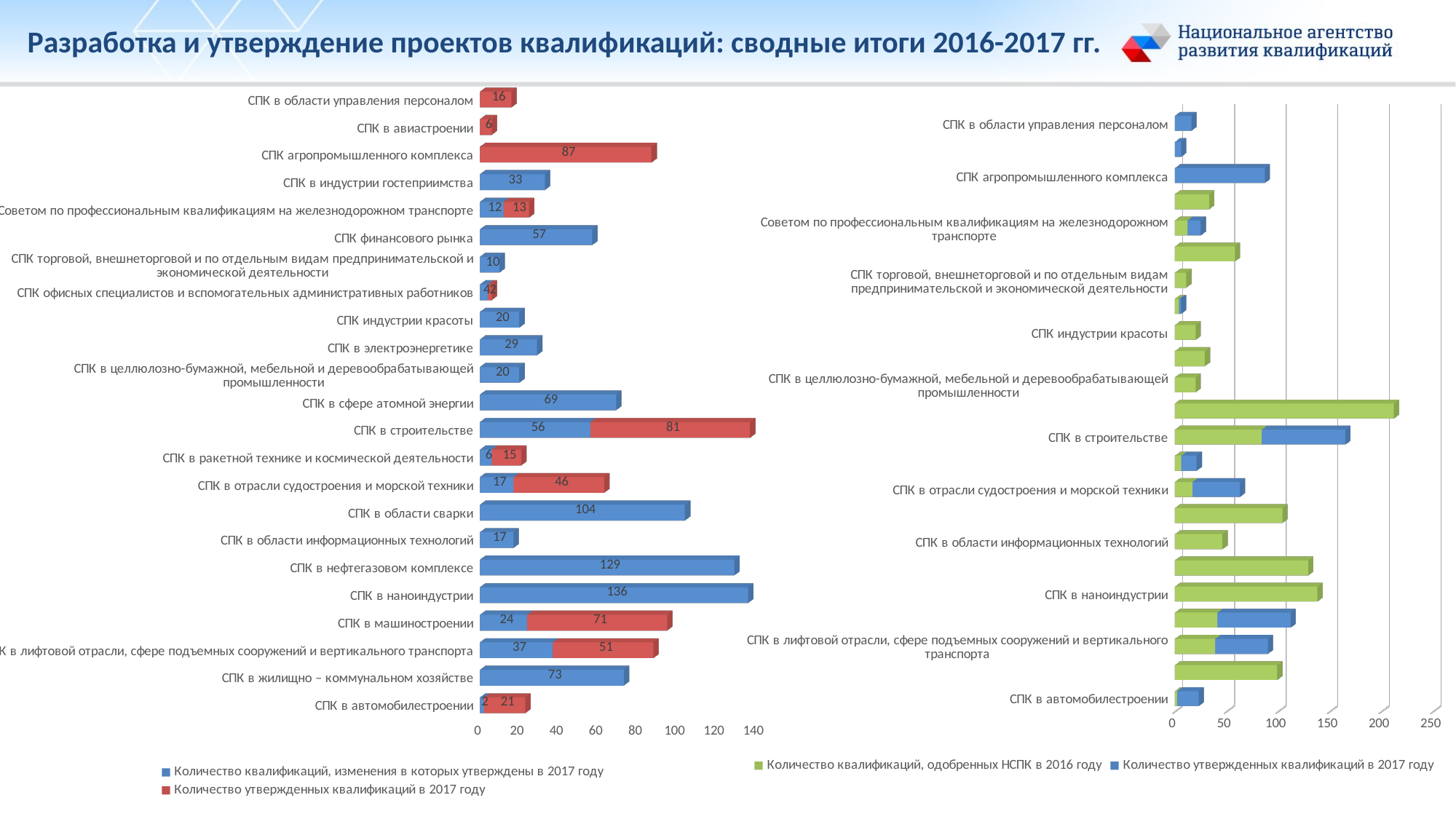
What kind of chart is the chart on the left of the slide? Bar chart On the left chart, what is the total of the stacked bar for СПК в машиностроении? 95 How many series does the legend of the left chart list? 2 On the right chart, is the green-series value (Количество квалификаций, одобренных НСПК в 2016 году) for СПК в строительстве greater or less than 200? less On the right chart, is the blue-series value (Количество утвержденных квалификаций в 2017 году) for СПК в автомобилестроении greater or less than 50? less On the left chart, which category has the highest value in the blue series (Количество квалификаций, изменения в которых утверждены в 2017 году)? СПК в наноиндустрии On the left chart, what is the difference between the values for СПК в нефтегазовом комплексе and СПК в области сварки? 25 On the left chart, what is the red-series value (Количество утвержденных квалификаций в 2017 году) for СПК агропромышленного комплекса? 87 On the left chart, what is the total of the stacked bar for СПК в строительстве? 137 On the left chart, what is the value for СПК в наноиндустрии? 136 On the left chart, which is larger: the value for СПК в сфере атомной энергии or the value for СПК финансового рынка? СПК в сфере атомной энергии